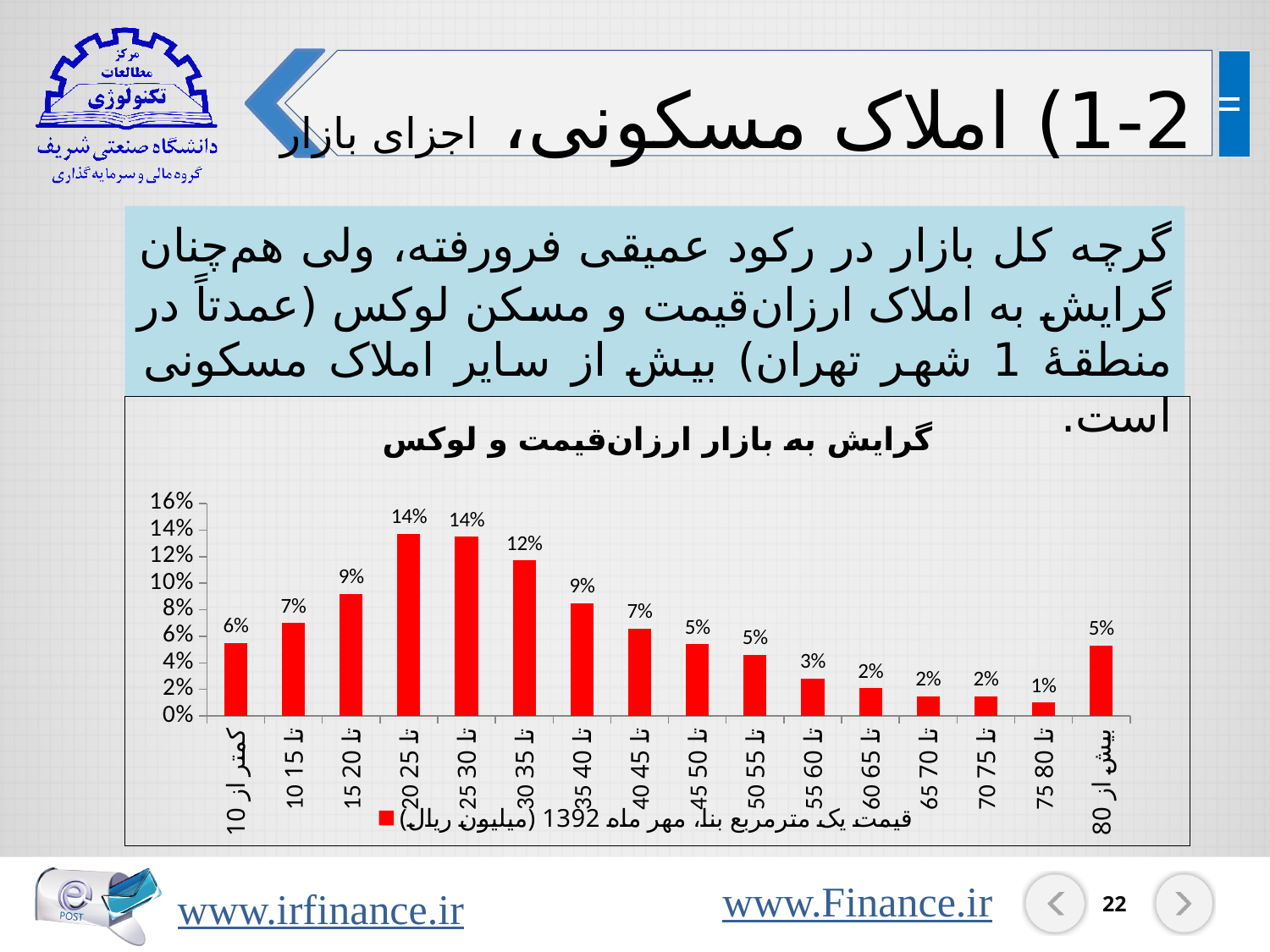
What is the value for the category 'بیش از 80'? 5% Do the values rise or fall from '25 تا 30' to '75 تا 80'? fall What is the difference between the values for '20 تا 25' and '75 تا 80'? 13% What is the value for the category 'کمتر از 10'? 6% How many categories are shown on the x axis? 16 How many series does the legend list? 1 What type of chart is shown on the slide? bar chart What is the title of the chart? گرایش به بازار ارزان‌قیمت و لوکس Which category has the lowest value? 75 تا 80 Is the value for '25 تا 30' greater or less than 10%? greater Which is larger, the value for '15 تا 20' or the value for '45 تا 50'? 15 تا 20 What is the value for the category '30 تا 35'? 12%